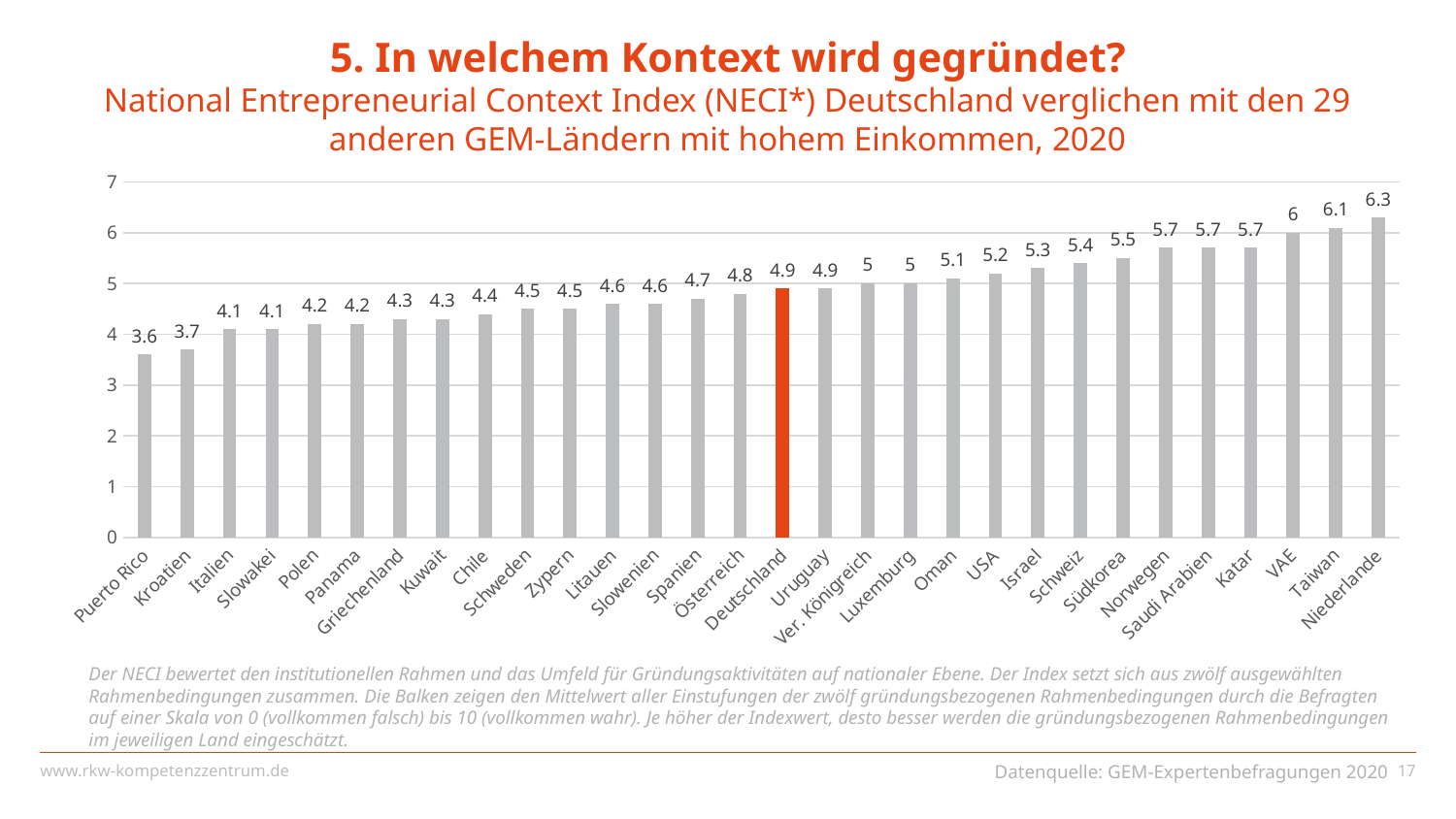
What is the NECI value for Deutschland? 4.9 What is the difference between the NECI values of Taiwan and Puerto Rico? 2.5 How many countries are shown in the chart? 30 Which country's bar is highlighted in orange? Deutschland What type of chart is shown on the slide? Bar chart What is the NECI value for Niederlande? 6.3 Which has a higher NECI value, USA or Chile? USA Which country has the highest NECI value? Niederlande What is the NECI value for Schweiz? 5.4 Do the values rise or fall from left to right along the x axis? Rise Which country has the lowest NECI value? Puerto Rico What is the difference between the NECI values of Niederlande and Deutschland? 1.4